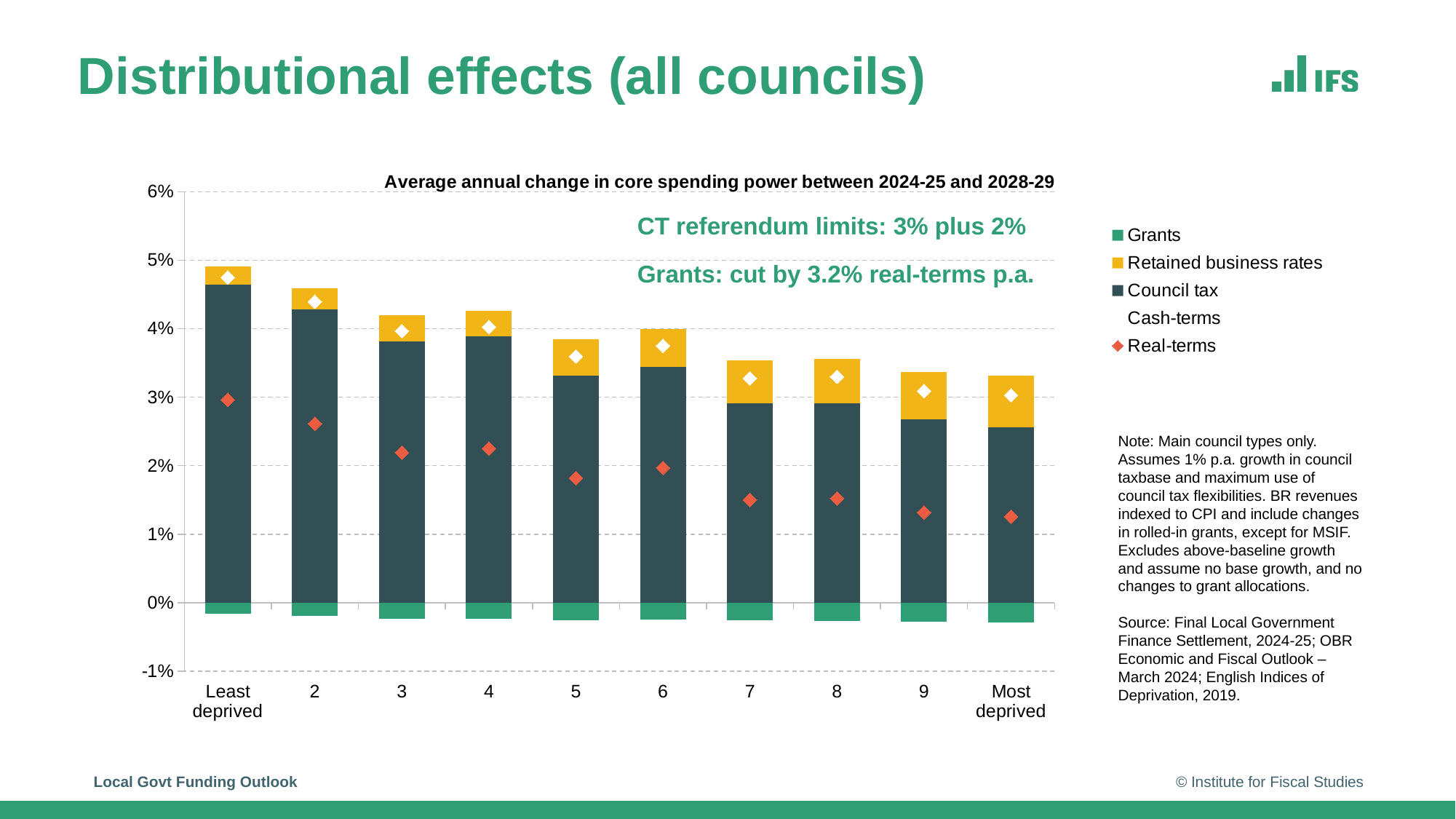
Which category has the highest Cash-terms value? Least deprived Which category has the highest Real-terms value? Least deprived Do the Cash-terms values generally rise or fall moving from Least deprived to Most deprived? fall Is the Cash-terms value for category 5 greater or less than 4%? less What kind of chart is shown on the slide? bar chart Is the Real-terms value for category 7 greater or less than 1%? greater How many deprivation categories are shown along the x axis? 10 Which is larger, the Real-terms value for category 2 or for category 3? category 2 Is the Cash-terms value for Least deprived greater or less than 4%? greater How many series does the legend list? 5 What is the title of the chart? Average annual change in core spending power between 2024-25 and 2028-29